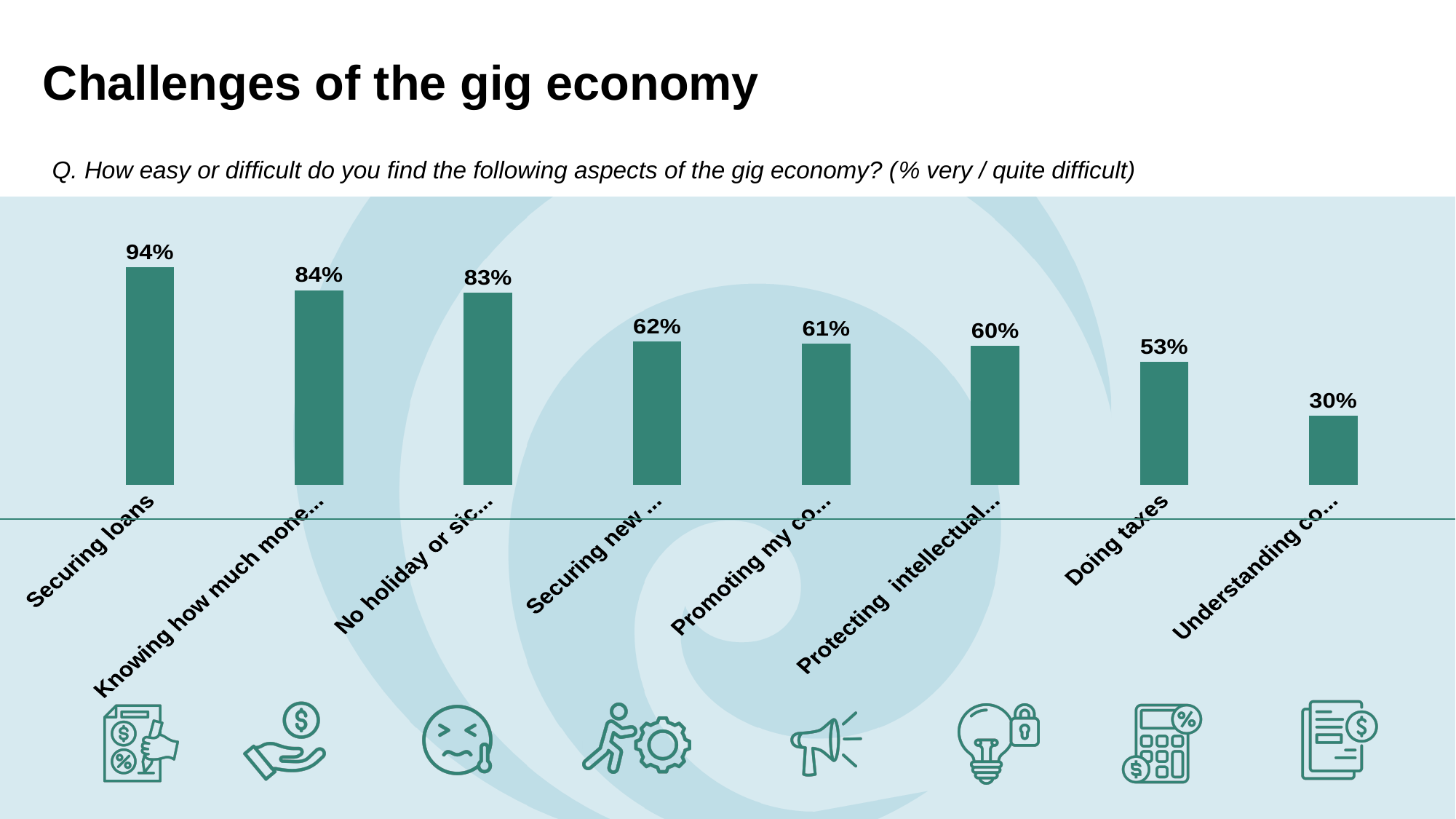
What type of chart is shown on the slide? Bar chart Do the bar values rise or fall from left to right across the chart? Fall What is the value of the lowest bar in the chart? 30% Which is larger, the value for Securing loans or the value for Doing taxes? Securing loans What is the value shown on the fourth bar from the left? 62% What is the difference between the values for Securing loans and Doing taxes? 41 percentage points How many bars are plotted in the chart? 8 Which category has the highest value in the chart? Securing loans What is the value shown on the second bar from the left? 84% What value is shown for Doing taxes? 53% What percentage of respondents find securing loans very or quite difficult? 94% What is the title of the slide containing the chart? Challenges of the gig economy